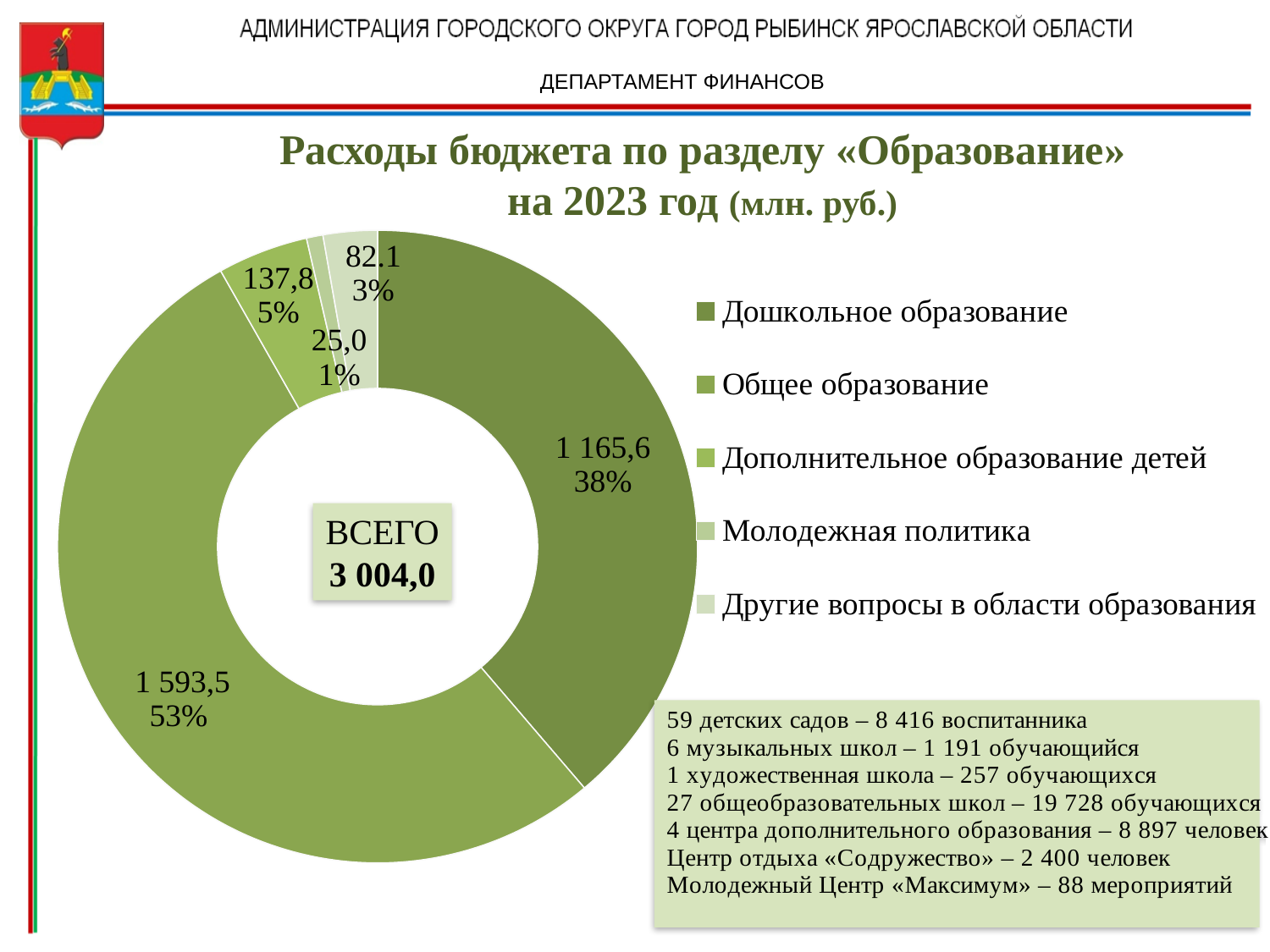
Какая общая сумма расходов (ВСЕГО) указана в центре диаграммы? 3 004,0 Какая категория имеет наибольшие расходы? Общее образование Какова сумма расходов на «Дополнительное образование детей»? 137,8 Сколько категорий перечислено в легенде диаграммы? 5 Какой тип диаграммы показан на слайде? кольцевая (круговая) диаграмма Какую долю занимают «Другие вопросы в области образования»? 3% Какова сумма расходов на «Молодежную политику»? 25,0 Какова сумма расходов на «Общее образование» по диаграмме? 1 593,5 Какова сумма расходов на «Дошкольное образование»? 1 165,6 Какую долю в расходах занимает «Дошкольное образование»? 38% Какая категория имеет наименьшие расходы? Молодежная политика На сколько расходы на «Общее образование» больше расходов на «Дошкольное образование»? 427,9